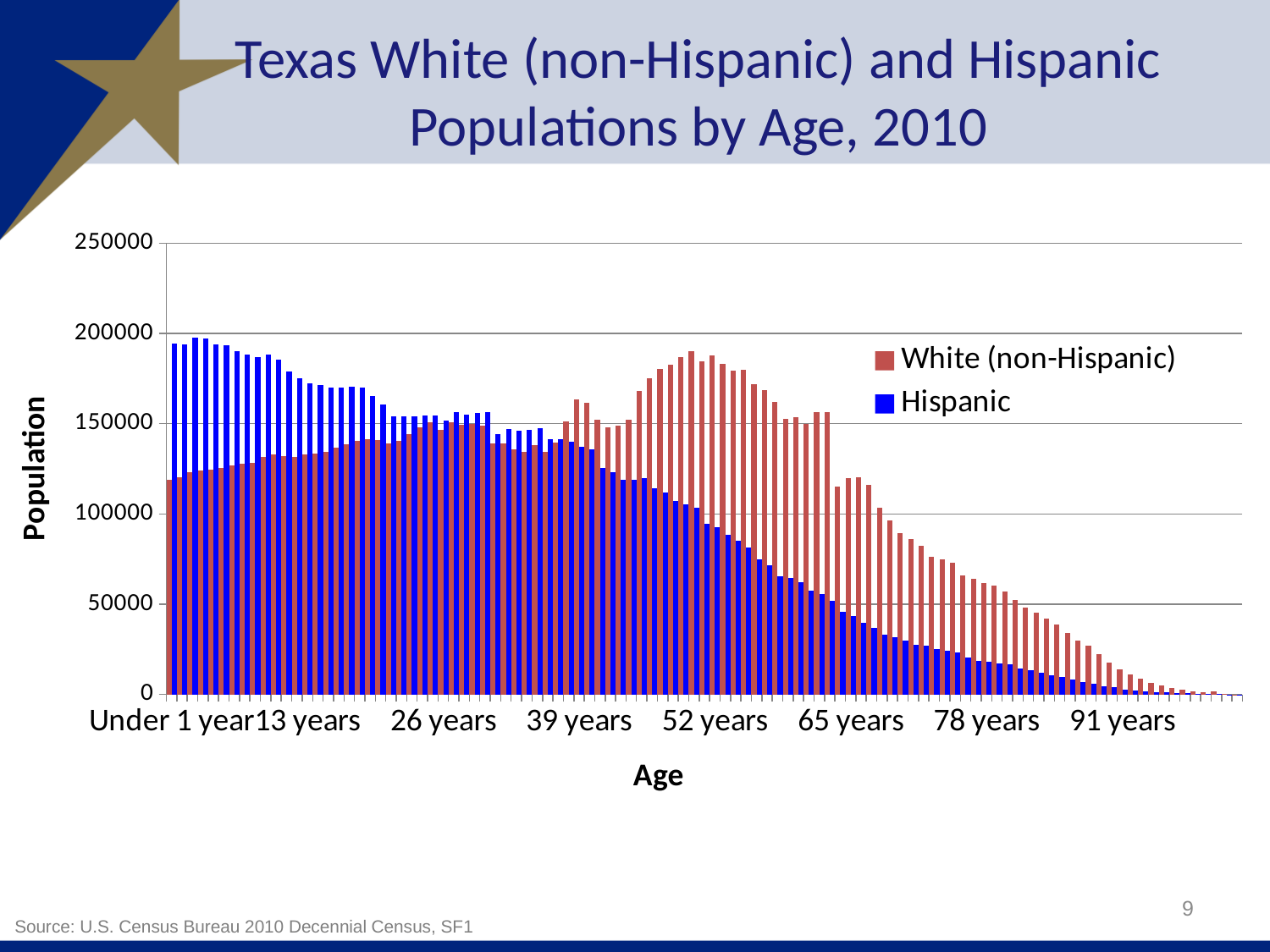
At 65 years, which series has the larger value, White (non-Hispanic) or Hispanic? White (non-Hispanic) Is the White (non-Hispanic) value for 52 years greater or less than 150000? greater Do the Hispanic values generally rise or fall as age increases from 26 years to 91 years? fall Is the Hispanic value for Under 1 year greater or less than 150000? greater What is the title of the chart? Texas White (non-Hispanic) and Hispanic Populations by Age, 2010 Is the White (non-Hispanic) value for Under 1 year greater or less than 150000? less Which two series are listed in the legend? White (non-Hispanic) and Hispanic What kind of chart is shown on the slide? bar chart At 91 years, which series has the larger value, White (non-Hispanic) or Hispanic? White (non-Hispanic) How many series does the legend list? 2 At Under 1 year, which series has the larger value, White (non-Hispanic) or Hispanic? Hispanic